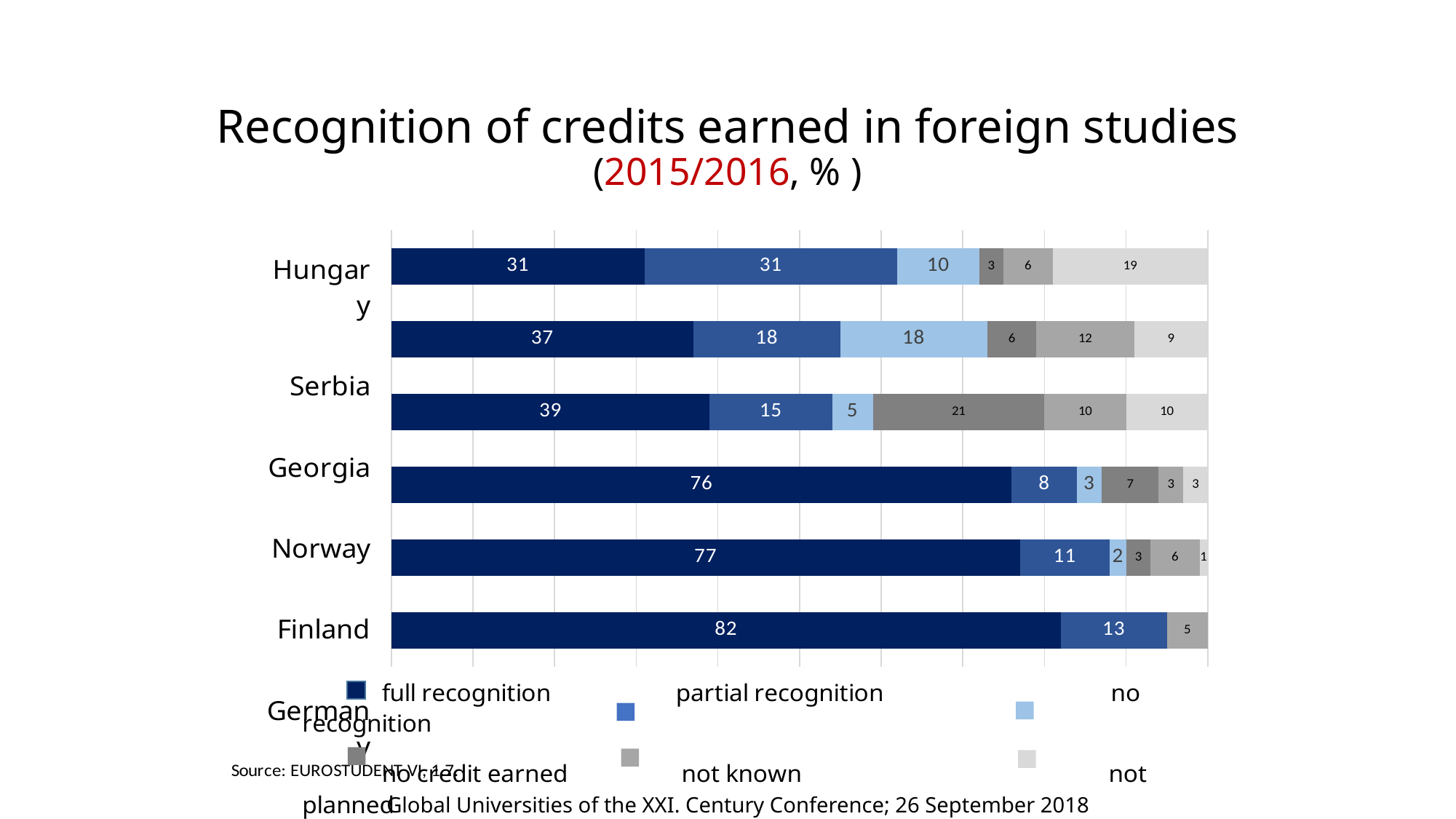
Which bar has the highest full recognition value? the bottom bar (82) What is the full recognition value in the top bar of the chart? 31 What is the difference between the full recognition value in the bottom bar (82) and in the top bar (31)? 51 What is the partial recognition value in the bottom bar of the chart? 13 What is the total of all segments in the top bar? 100 Which bar has the lowest full recognition value? the top bar (31) What is the 'no credit earned' value in the third bar from the top? 21 How many stacked bars are plotted in the chart? 6 Which has the larger partial recognition value, the top bar or the bottom bar? the top bar What is the full recognition value in the bottom bar of the chart? 82 How many series does the legend list? 6 What kind of chart is shown on the slide? bar chart